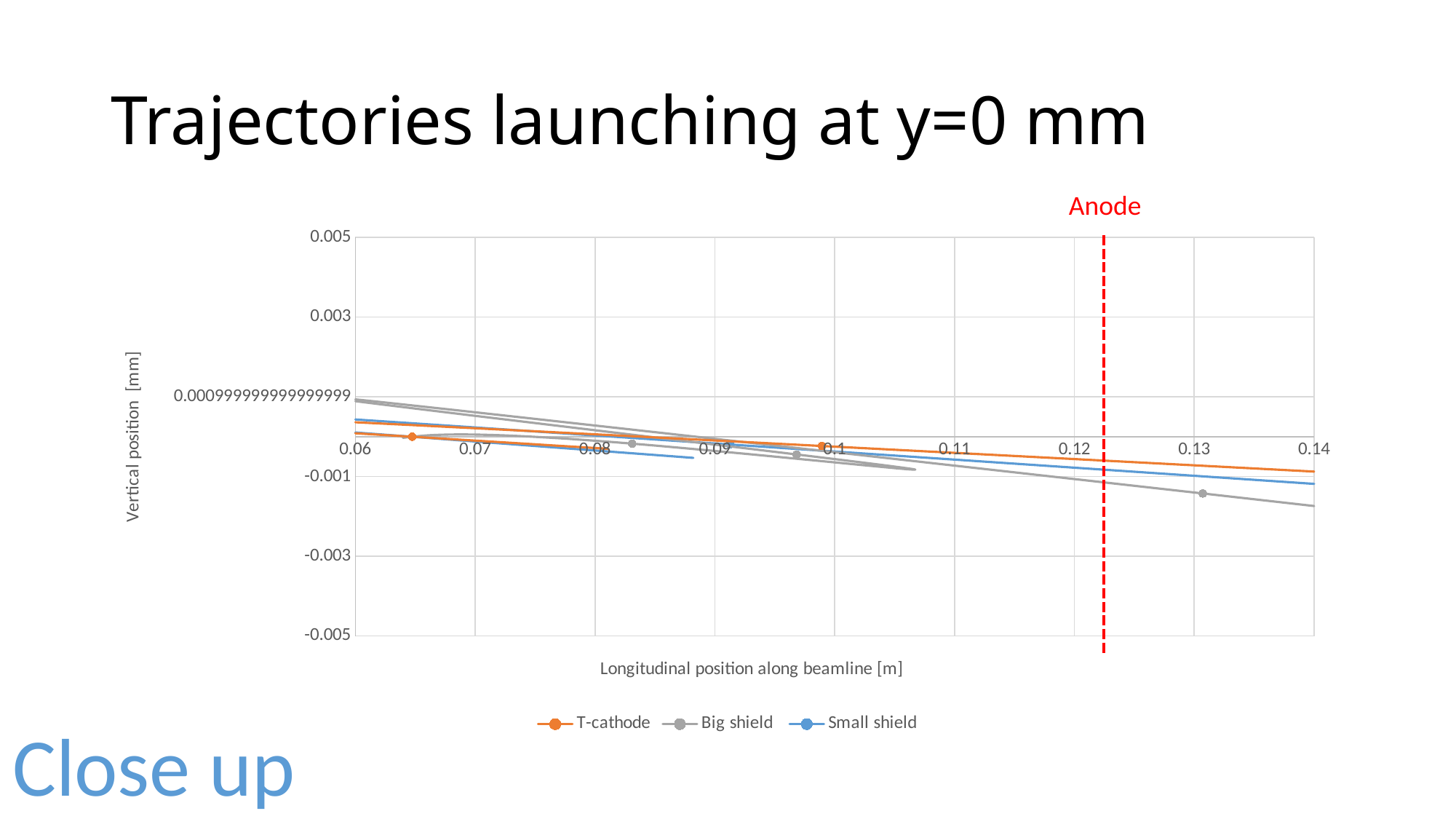
How many series does the legend list? 3 Do the trajectory values rise or fall as the longitudinal position increases from 0.06 to 0.14? Fall Is the Big shield value at a longitudinal position of 0.06 greater or less than 0? greater What is the label of the x axis? Longitudinal position along beamline [m] What kind of chart is shown on the slide? Line chart At a longitudinal position of 0.14, which is higher, T-cathode or Big shield? T-cathode At a longitudinal position of 0.14, which series has the lowest vertical position? Big shield Is the Small shield value at a longitudinal position of 0.06 greater or less than 0.003? less Is the Big shield value at a longitudinal position of 0.14 greater or less than -0.001? less At a longitudinal position of 0.14, which is higher, Small shield or Big shield? Small shield